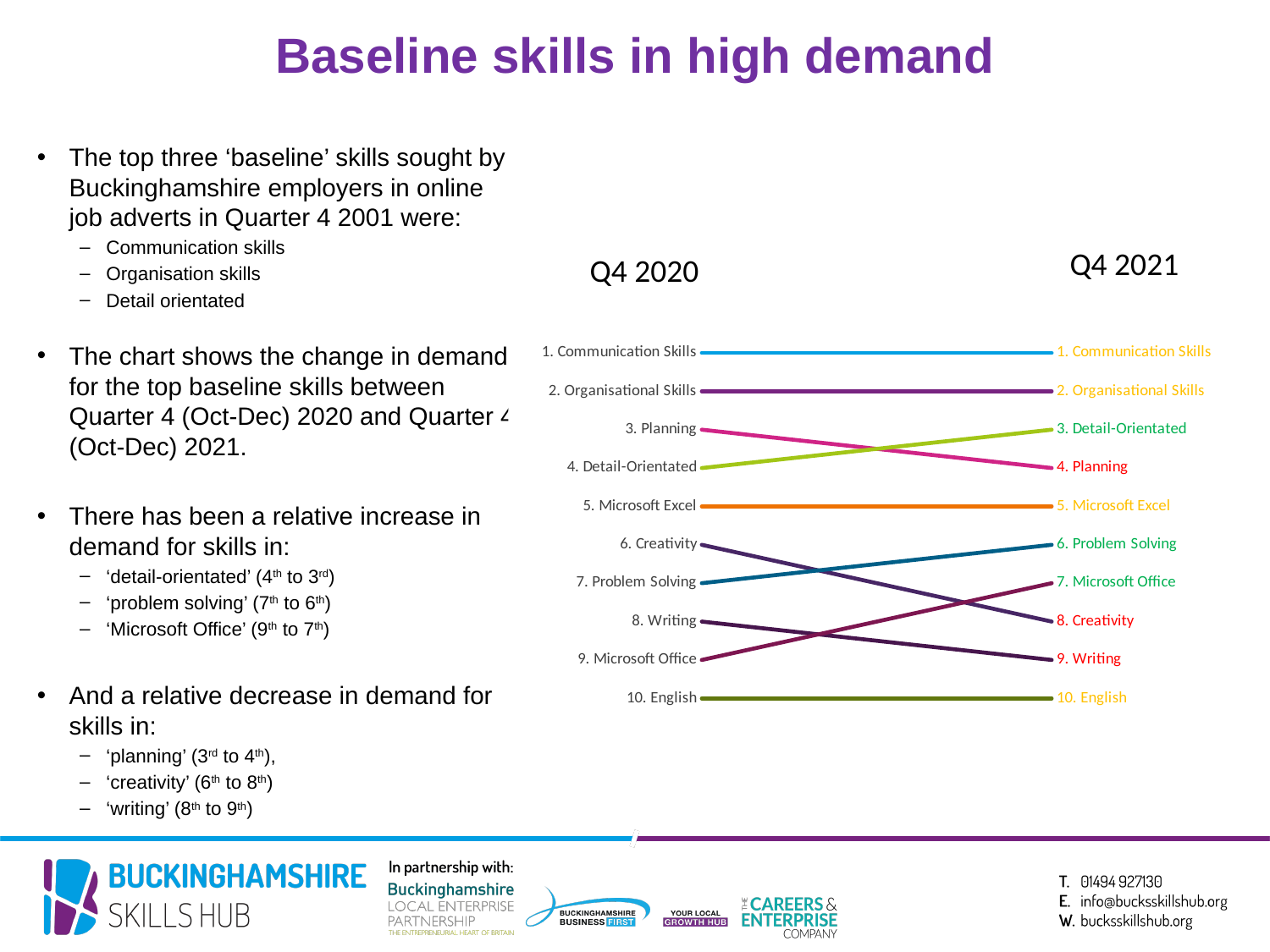
Which two time periods does the chart compare? Q4 2020 and Q4 2021 Which skill is ranked 8th in Q4 2020? Writing What rank did Microsoft Office hold in Q4 2020? 9 What rank did Planning hold in Q4 2021 on the chart? 4 By how many places did Creativity's rank change between Q4 2020 and Q4 2021? 2 What rank did Microsoft Office hold in Q4 2021? 7 What rank did Planning hold in Q4 2020 on the chart? 3 Which skill is ranked lowest (10th) in Q4 2021? English Which skill holds the top rank in both Q4 2020 and Q4 2021? Communication Skills How many skills are ranked on the chart? 10 What kind of chart is shown on the slide? Line chart (slope chart) Which skill is ranked 6th in Q4 2021? Problem Solving